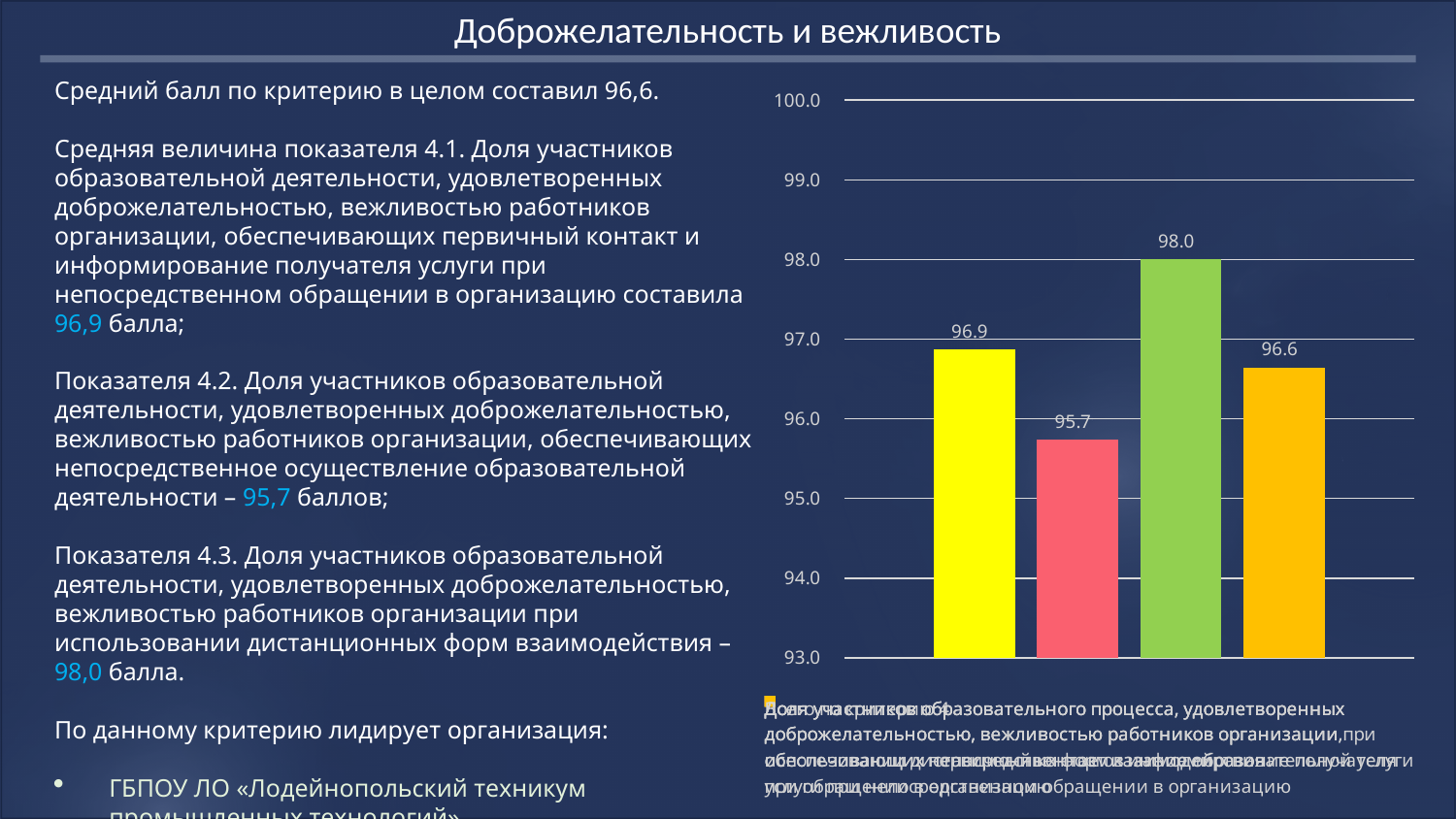
What type of chart is shown on the slide? bar chart What is the difference between the green bar's value and the red bar's value? 2.3 What is the title of the slide containing the chart? Доброжелательность и вежливость What is the value shown on the yellow bar (first from the left)? 96.9 What is the value shown on the red bar (second from the left)? 95.7 Is the value of the red bar greater or less than 96.0? less Which bar has the highest value in the chart? the green bar (98.0) How many bars are plotted in the chart? 4 What is the value shown on the orange bar (fourth from the left)? 96.6 Which is larger, the value of the yellow bar or the value of the orange bar? the yellow bar (96.9) What is the value shown on the green bar (third from the left)? 98.0 Which bar has the lowest value in the chart? the red bar (95.7)